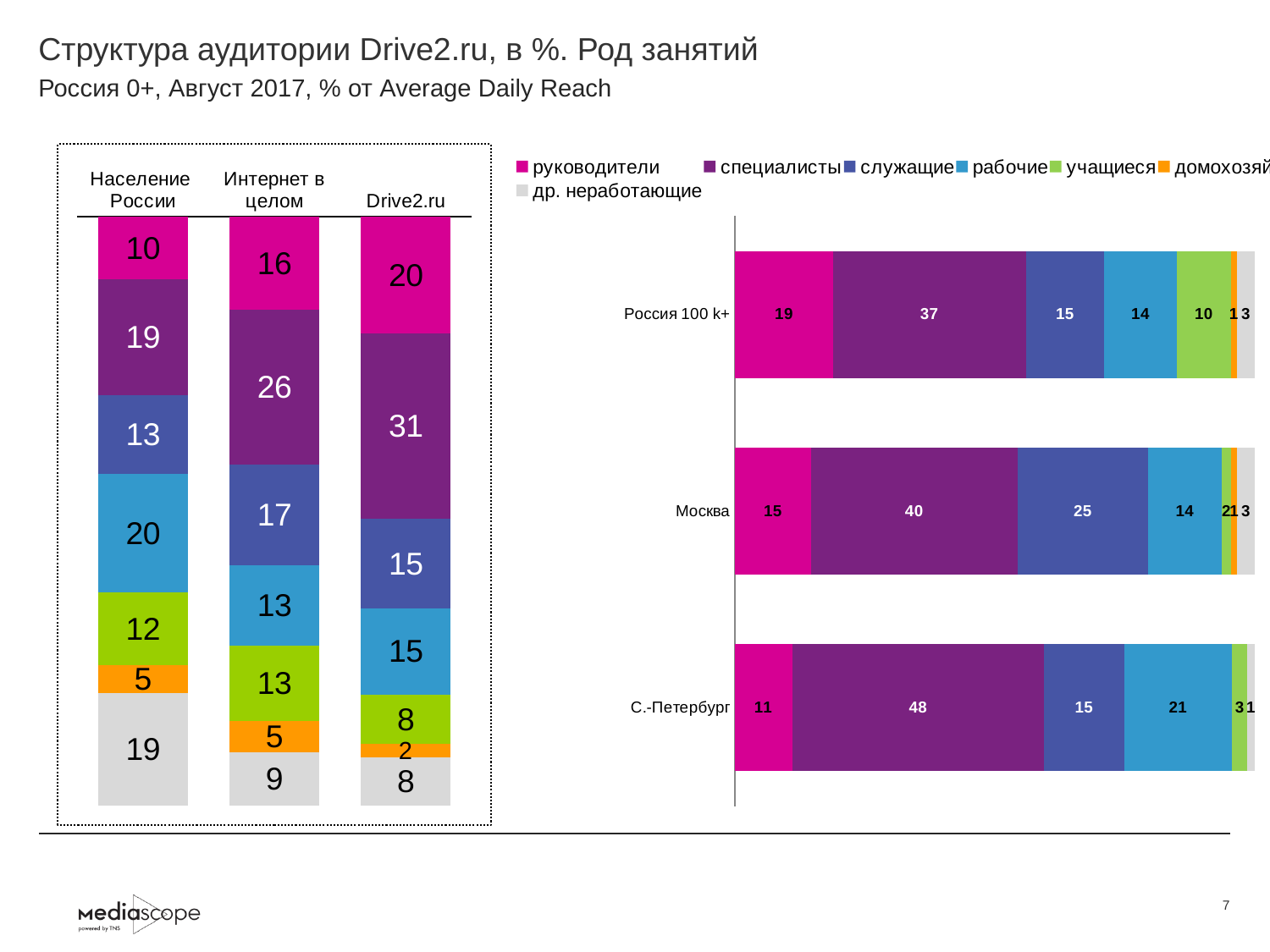
In the right chart, which region has the highest value for специалисты? С.-Петербург In the left chart, what is the value for специалисты in the Drive2.ru bar? 31 In the right chart, what is the value for специалисты for С.-Петербург? 48 In the left chart, what is the value for руководители in the Население России bar? 10 In the right chart, what is the value for служащие for Москва? 25 In the left chart, what is the difference between the руководители values for Drive2.ru and Население России? 10 How many series does the legend list? 7 What kind of chart is the right chart? Stacked bar chart In the left chart, which bar has the lowest value for домохозяйки? Drive2.ru In the left chart, what is the value for др. неработающие in the Интернет в целом bar? 9 In the right chart, which is larger: рабочие for С.-Петербург or рабочие for Москва? С.-Петербург How many regions are shown in the right chart? 3